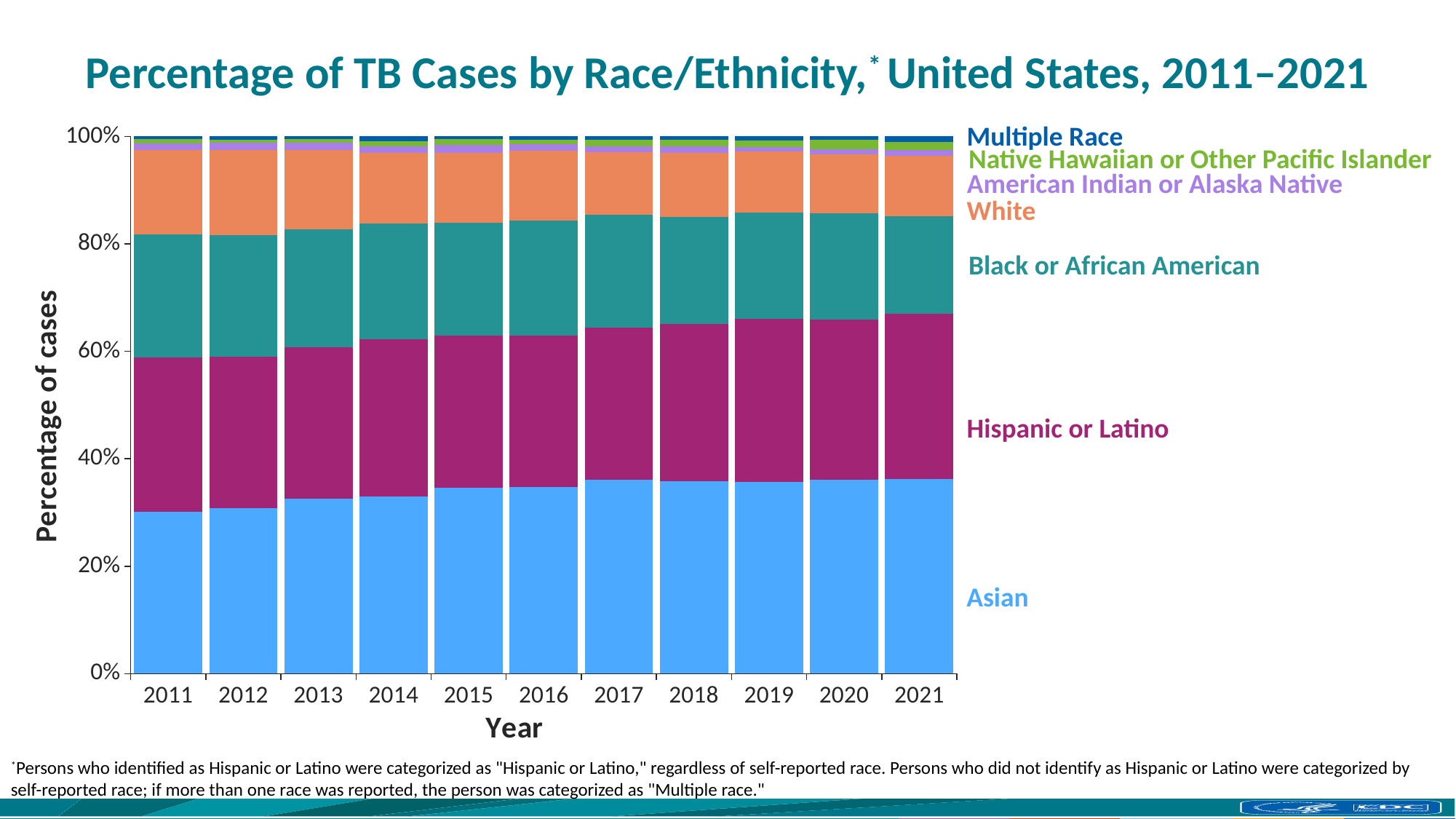
What is the total of each stacked bar? 100% In 2011, which is larger: the Black or African American share or the White share of TB cases? Black or African American Does the Asian share of TB cases rise or fall from 2011 to 2021? rise How many years are shown along the x axis? 11 What kind of chart is shown on the slide? Stacked bar chart How many race/ethnicity series does the legend list? 7 In 2021, which race/ethnicity group has the largest share of TB cases? Asian Is the Asian share of TB cases in 2011 greater or less than 40%? less Which series is shown in orange? White Is the Asian share of TB cases in 2021 greater or less than 20%? greater Does the White share of TB cases rise or fall from 2011 to 2021? fall What is the title of the chart? Percentage of TB Cases by Race/Ethnicity, United States, 2011–2021